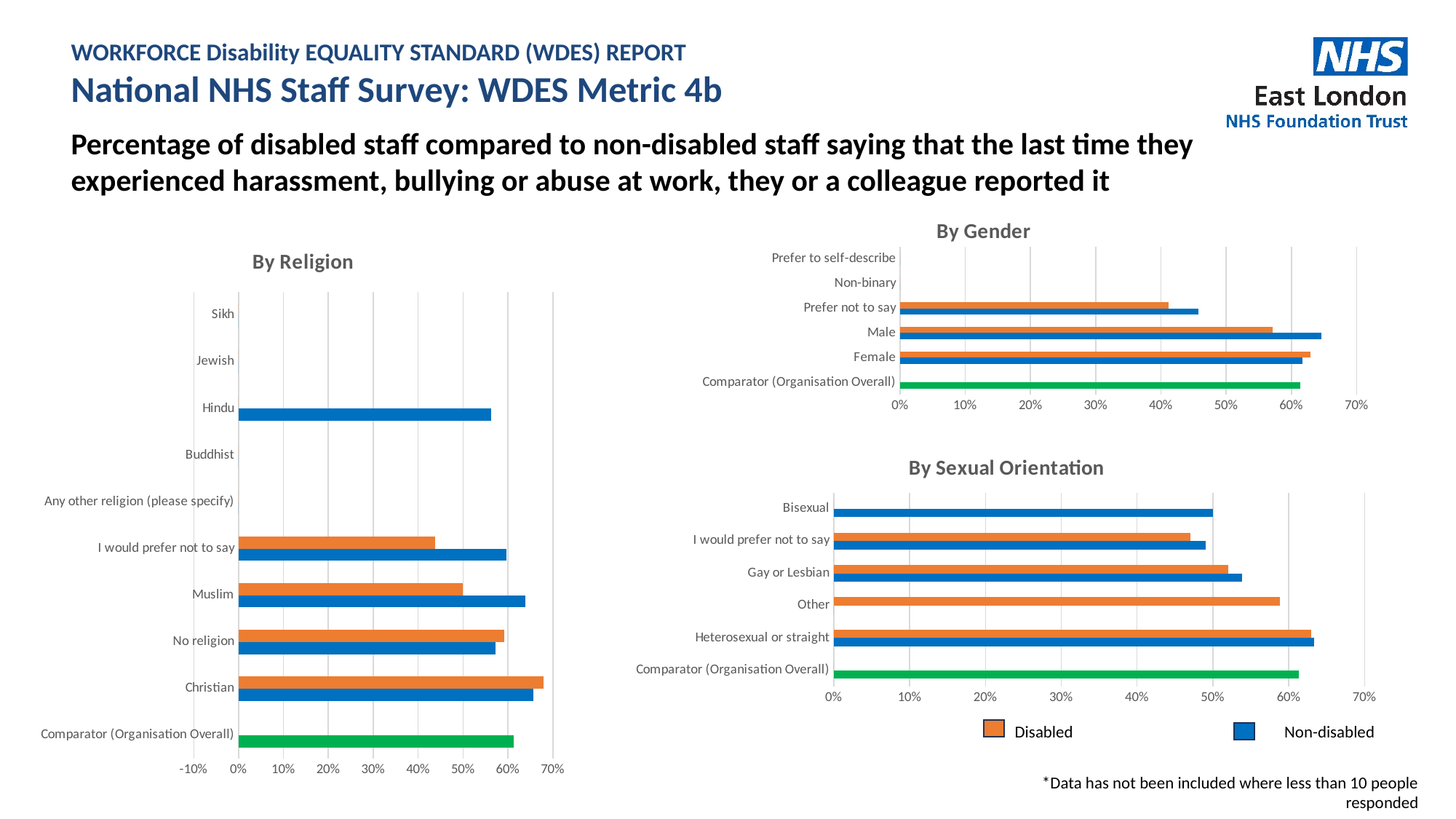
In the 'By Religion' chart, is the Non-disabled value for Hindu greater or less than 50%? greater How many categories are listed on the vertical axis of the 'By Religion' chart? 10 In the 'By Gender' chart, is the Disabled value for 'Prefer not to say' greater or less than 50%? less In the 'By Sexual Orientation' chart, which category has the lowest Disabled value? I would prefer not to say How many series does the legend at the bottom right of the slide list? 2 In the 'By Religion' chart, which category has the highest Disabled value? Christian In the 'By Religion' chart, for Muslim, which is larger: the Disabled value or the Non-disabled value? Non-disabled In the 'By Gender' chart, for Male, which is larger: the Disabled value or the Non-disabled value? Non-disabled What kind of chart is the 'By Religion' chart? bar chart In the 'By Sexual Orientation' chart, is the Disabled value for 'Other' greater or less than 50%? greater In the 'By Gender' chart, which gender category has the lowest Disabled value? Prefer not to say